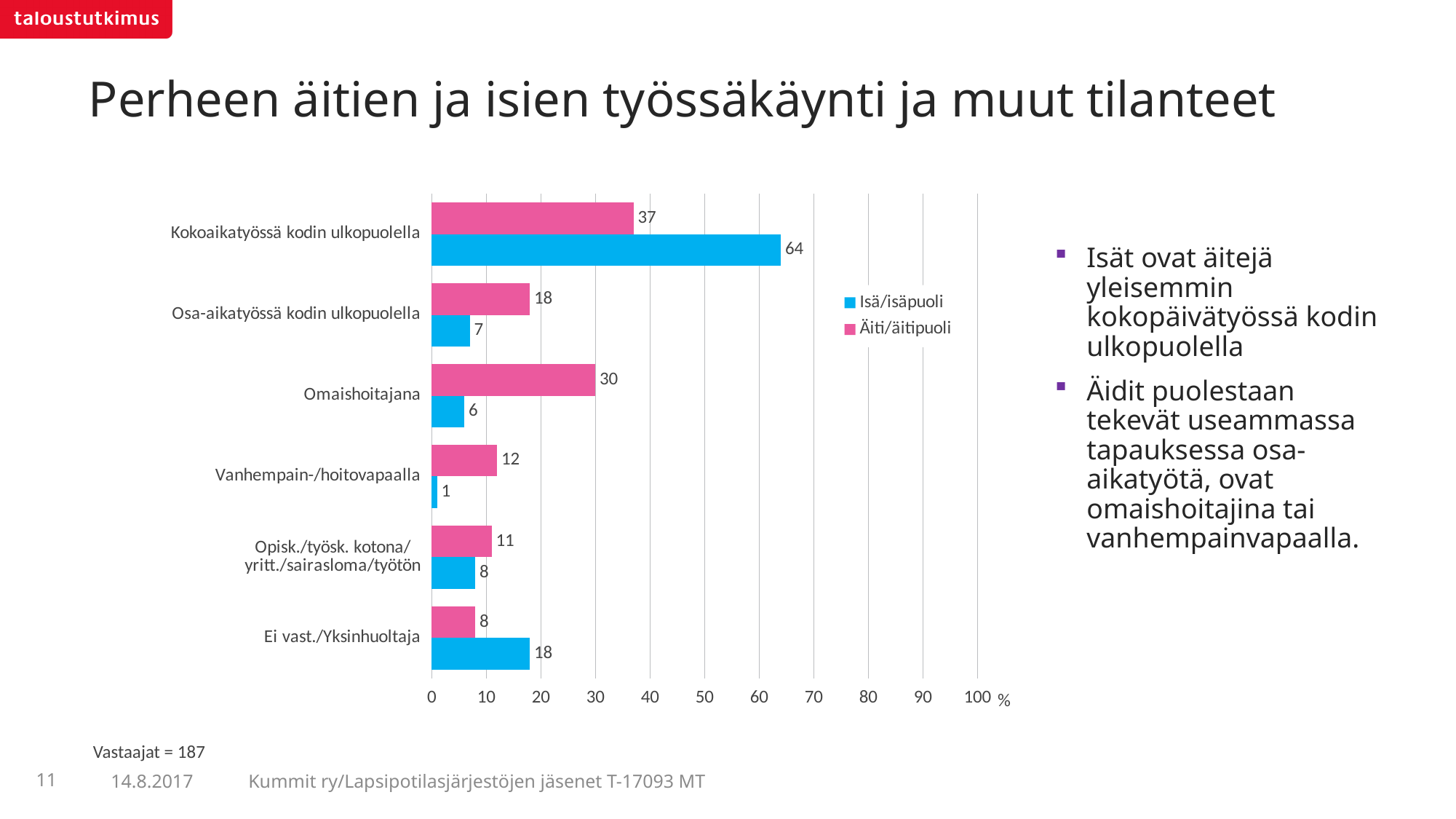
What is the difference between the Isä/isäpuoli and Äiti/äitipuoli values for Kokoaikatyössä kodin ulkopuolella? 27 Which is larger for Osa-aikatyössä kodin ulkopuolella: the Isä/isäpuoli value or the Äiti/äitipuoli value? Äiti/äitipuoli Which colour represents the Äiti/äitipuoli series in the chart? Pink Which category has the highest value for the Äiti/äitipuoli series? Kokoaikatyössä kodin ulkopuolella Which category has the lowest value for the Isä/isäpuoli series? Vanhempain-/hoitovapaalla What is the value for Isä/isäpuoli in the category Vanhempain-/hoitovapaalla? 1 What is the value for Äiti/äitipuoli in the category Omaishoitajana? 30 What kind of chart is shown on the slide? Bar chart How many series does the legend list? 2 Which is larger for Ei vast./Yksinhuoltaja: the Isä/isäpuoli value or the Äiti/äitipuoli value? Isä/isäpuoli What is the value for Isä/isäpuoli in the category Kokoaikatyössä kodin ulkopuolella? 64 How many categories are shown on the chart? 6